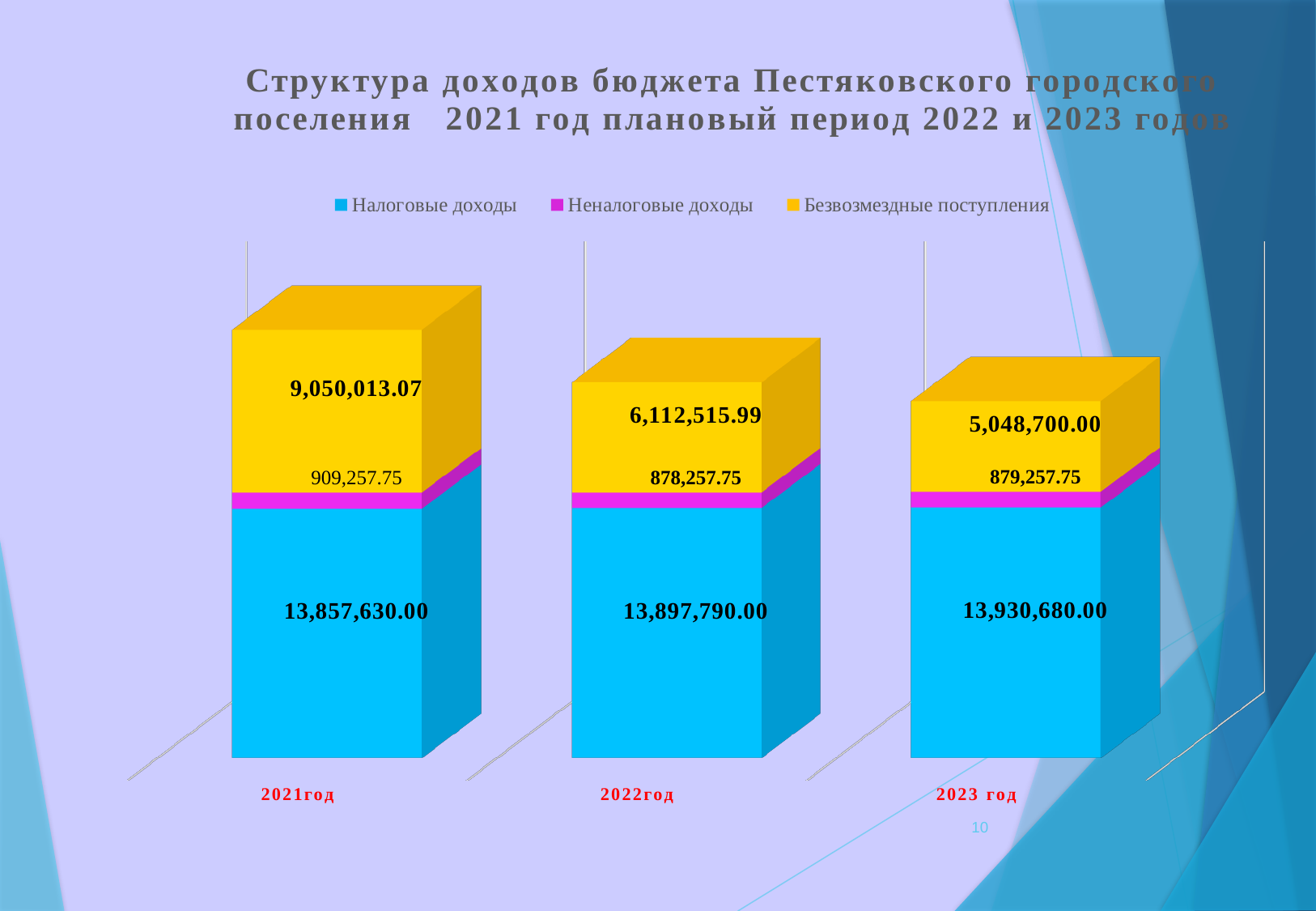
How many series does the legend list? 3 In which year is Безвозмездные поступления highest? 2021год What kind of chart is shown on the slide? Stacked bar chart What is the value of Безвозмездные поступления for 2022год? 6,112,515.99 What is the difference between Безвозмездные поступления in 2021год and 2022год? 2,937,497.08 Do the values of Безвозмездные поступления rise or fall from 2021год to 2023 год? Fall Which is larger: Налоговые доходы in 2022год or in 2023 год? 2023 год In which year is Безвозмездные поступления lowest? 2023 год How many years (categories) are shown on the x axis? 3 What is the total of the stacked bar for 2023 год? 19,858,637.75 What is the value of Неналоговые доходы for 2023 год? 879,257.75 What is the value of Налоговые доходы for 2021год? 13,857,630.00